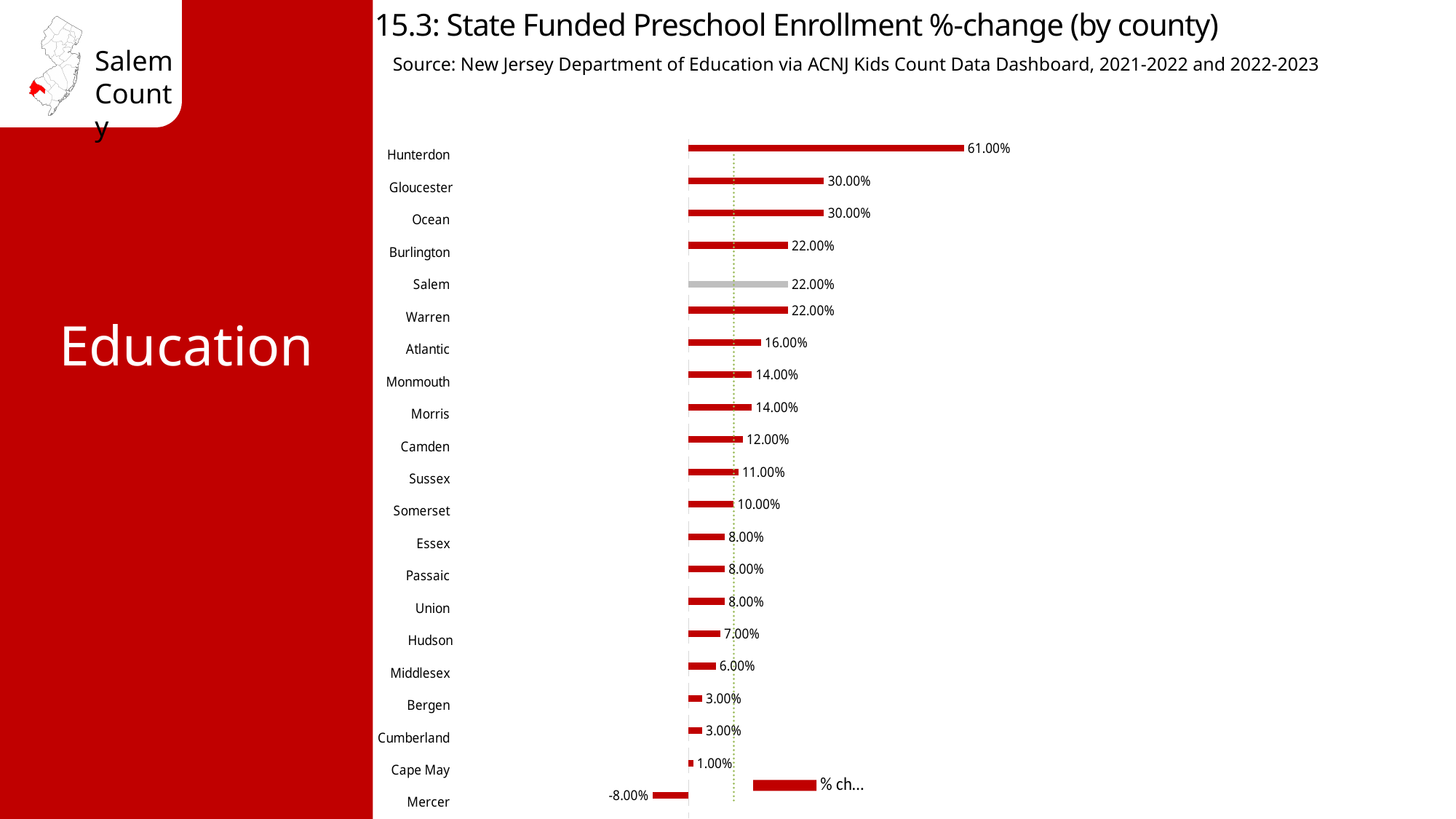
Which county has the highest %-change? Hunterdon What is the difference between the %-change for Hunterdon and Gloucester? 31.00% What type of chart is shown on the slide? Bar chart What is the %-change value shown for Mercer? -8.00% Which county has the lowest %-change? Mercer How many counties are shown in the chart? 21 Which county's bar is coloured grey instead of red? Salem What is the %-change value shown for Atlantic? 16.00% What is the %-change value shown for Hunterdon? 61.00% What is the state funded preschool enrollment %-change for Salem? 22.00% Which has a larger %-change, Camden or Middlesex? Camden What is the difference between the %-change for Salem and Cape May? 21.00%